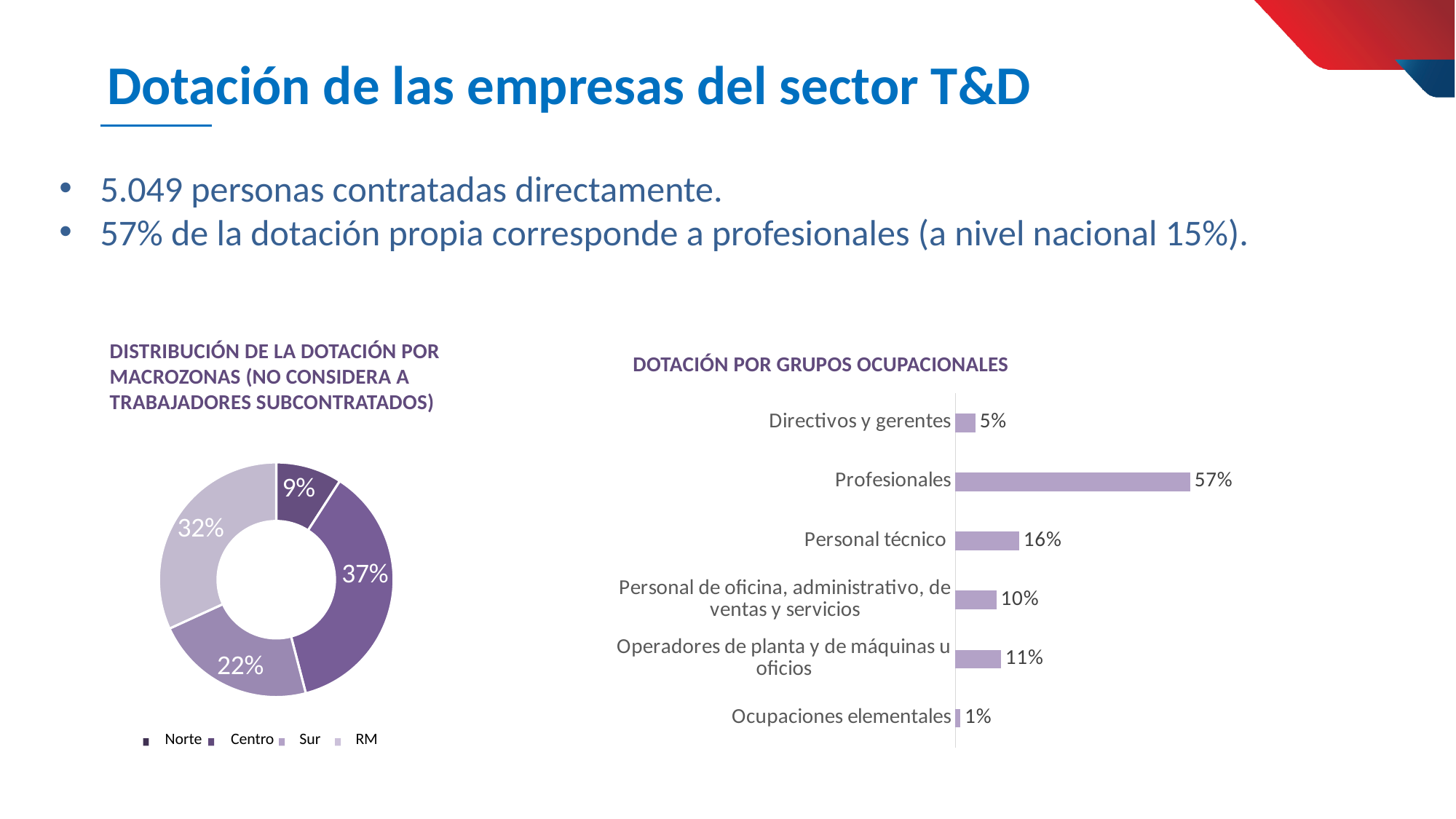
How many occupational groups are shown in the 'Dotación por grupos ocupacionales' chart? 6 In the 'Dotación por grupos ocupacionales' chart, which group has the highest value? Profesionales In the 'Dotación por grupos ocupacionales' chart, what is the difference between Profesionales and Personal técnico? 41% In the 'Distribución de la dotación por macrozonas' chart, what share does Centro have? 37% How many entries does the legend of the 'Distribución de la dotación por macrozonas' chart list? 4 In the 'Dotación por grupos ocupacionales' chart, which is larger: Directivos y gerentes or Operadores de planta y de máquinas u oficios? Operadores de planta y de máquinas u oficios What kind of chart is 'Dotación por grupos ocupacionales'? Bar chart In the 'Dotación por grupos ocupacionales' chart, which group has the lowest value? Ocupaciones elementales In the 'Dotación por grupos ocupacionales' chart, what is the value for Personal técnico? 16% In the 'Distribución de la dotación por macrozonas' chart, which macrozone has the largest share? Centro In the 'Distribución de la dotación por macrozonas' chart, what share does Norte have? 9% In the 'Dotación por grupos ocupacionales' chart, what is the value for Profesionales? 57%